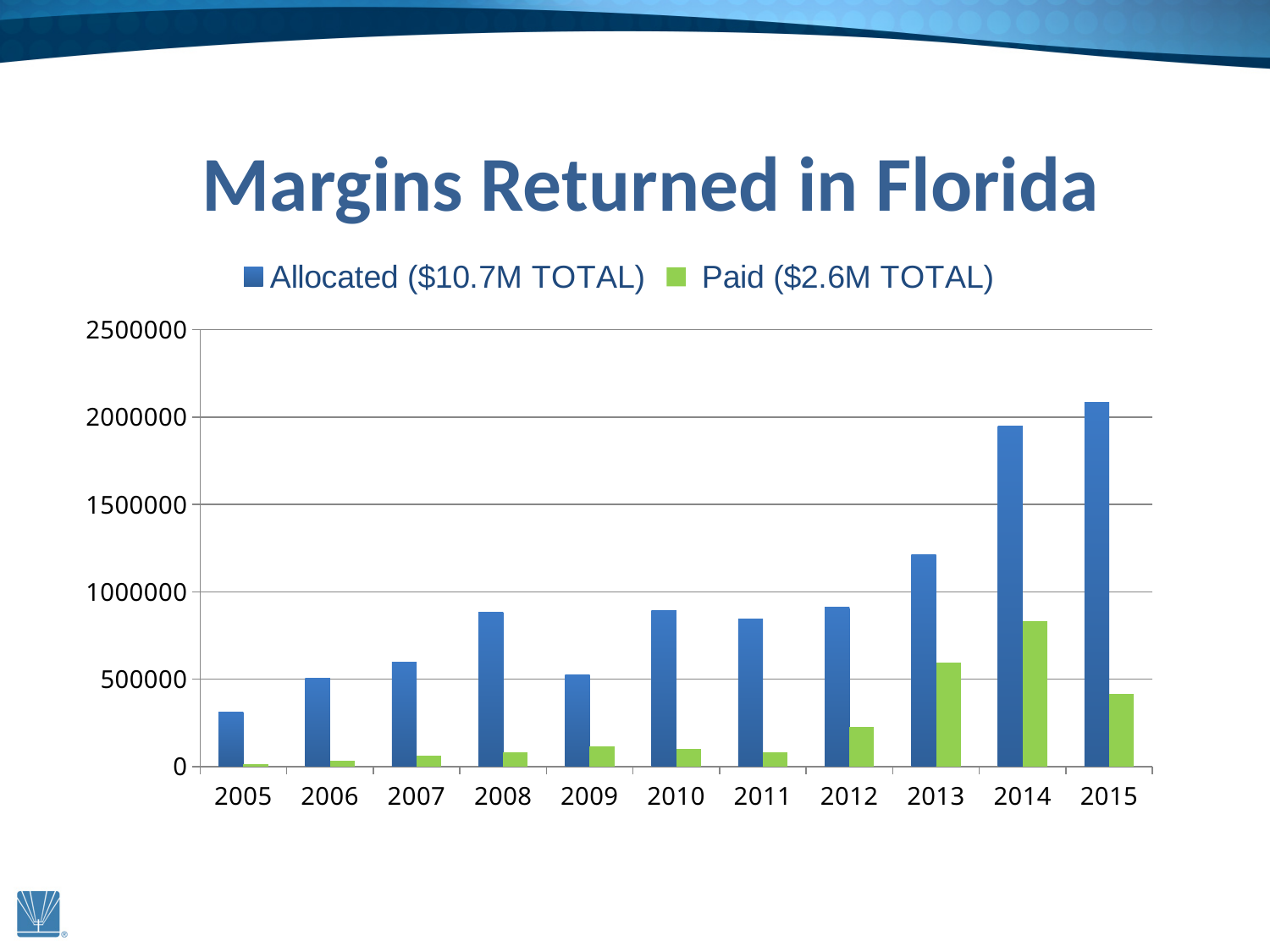
Which year has the highest Allocated value? 2015 Is the Allocated value for 2014 greater or less than 1500000? greater Which year has the highest Paid value? 2014 Is the Paid value for 2015 greater or less than 500000? less Do the Allocated values generally rise or fall from 2005 to 2015? rise What total does the legend give for the Paid series? $2.6M TOTAL What kind of chart is shown on the slide? bar chart Which year has the lowest Allocated value? 2005 How many years are shown on the x axis? 11 How many series does the legend list? 2 What is the title of the chart? Margins Returned in Florida Which is larger, the Allocated value for 2013 or the Allocated value for 2012? 2013